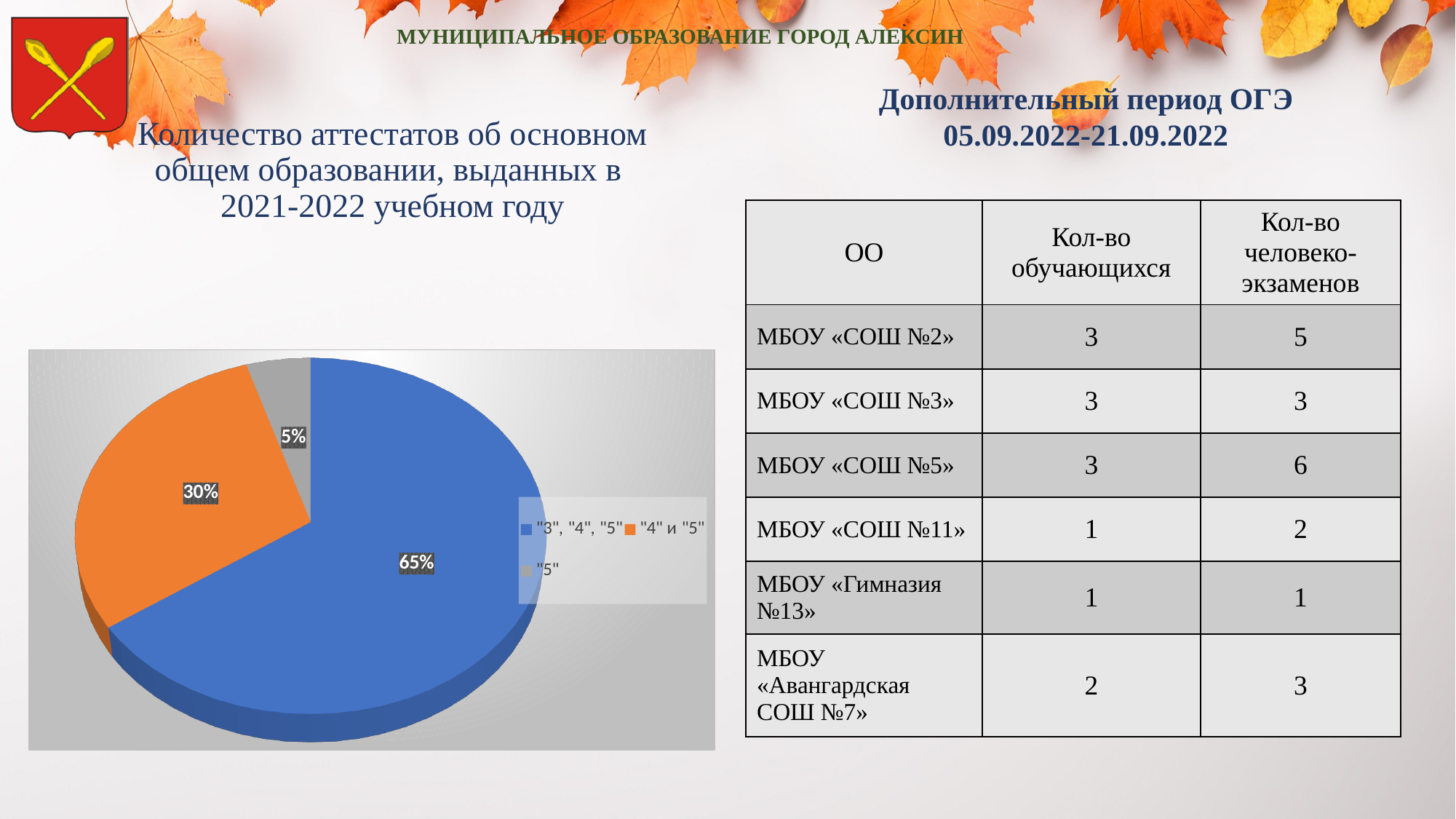
How many entries does the legend of the pie chart list? 3 What share of the pie does the "5" slice have? 5% What colour is the "4" и "5" slice in the pie chart? orange Which slice is larger: "4" и "5" or "5"? "4" и "5" What share of the pie does the "3", "4", "5" slice have? 65% Which slice of the pie chart is the largest? "3", "4", "5" Which slice of the pie chart is the smallest? "5" What is the difference in percentage points between the "3", "4", "5" slice and the "4" и "5" slice? 35 What colour is the "3", "4", "5" slice in the pie chart? blue What kind of chart is shown on the slide? pie chart How many slices does the pie chart have? 3 What share of the pie does the "4" и "5" slice have? 30%